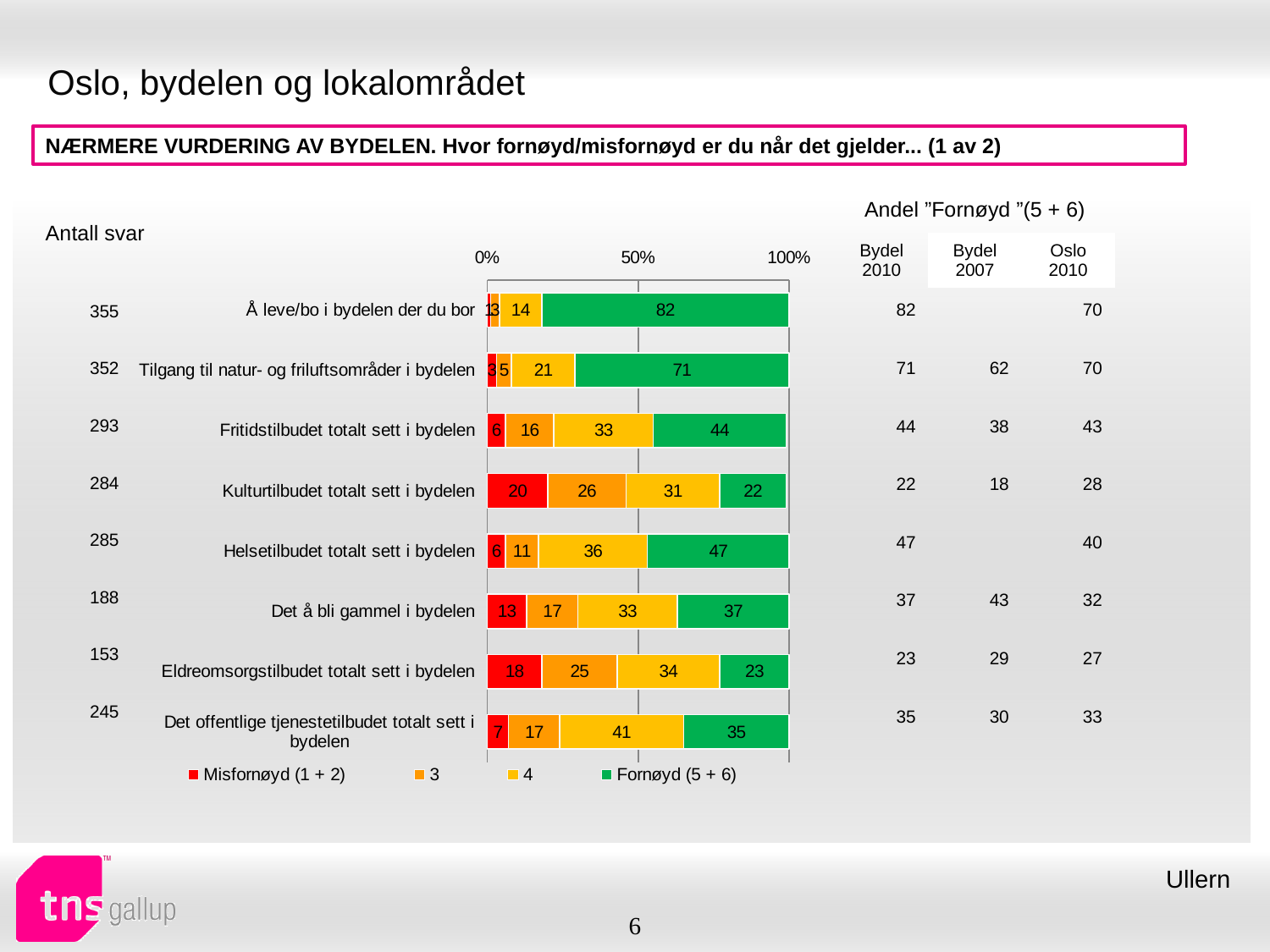
What is the value of the '3' segment for Det å bli gammel i bydelen? 17 Which category has the highest Misfornøyd (1 + 2) value? Kulturtilbudet totalt sett i bydelen What is the difference between the Fornøyd (5 + 6) values for Helsetilbudet totalt sett i bydelen and Fritidstilbudet totalt sett i bydelen? 3 Which category has the highest Fornøyd (5 + 6) value? Å leve/bo i bydelen der du bor How many series does the legend list? 4 What is the value of the '4' segment for Det offentlige tjenestetilbudet totalt sett i bydelen? 41 What kind of chart is shown on the slide? Stacked bar chart Which has a larger Fornøyd (5 + 6) value: Tilgang til natur- og friluftsområder i bydelen or Det å bli gammel i bydelen? Tilgang til natur- og friluftsområder i bydelen What is the Misfornøyd (1 + 2) value for Eldreomsorgstilbudet totalt sett i bydelen? 18 What is the value of the Fornøyd (5 + 6) segment for Kulturtilbudet totalt sett i bydelen? 22 What is the total of the stacked bar for Kulturtilbudet totalt sett i bydelen, summing the printed segment values? 99 How many categories are shown in the chart? 8